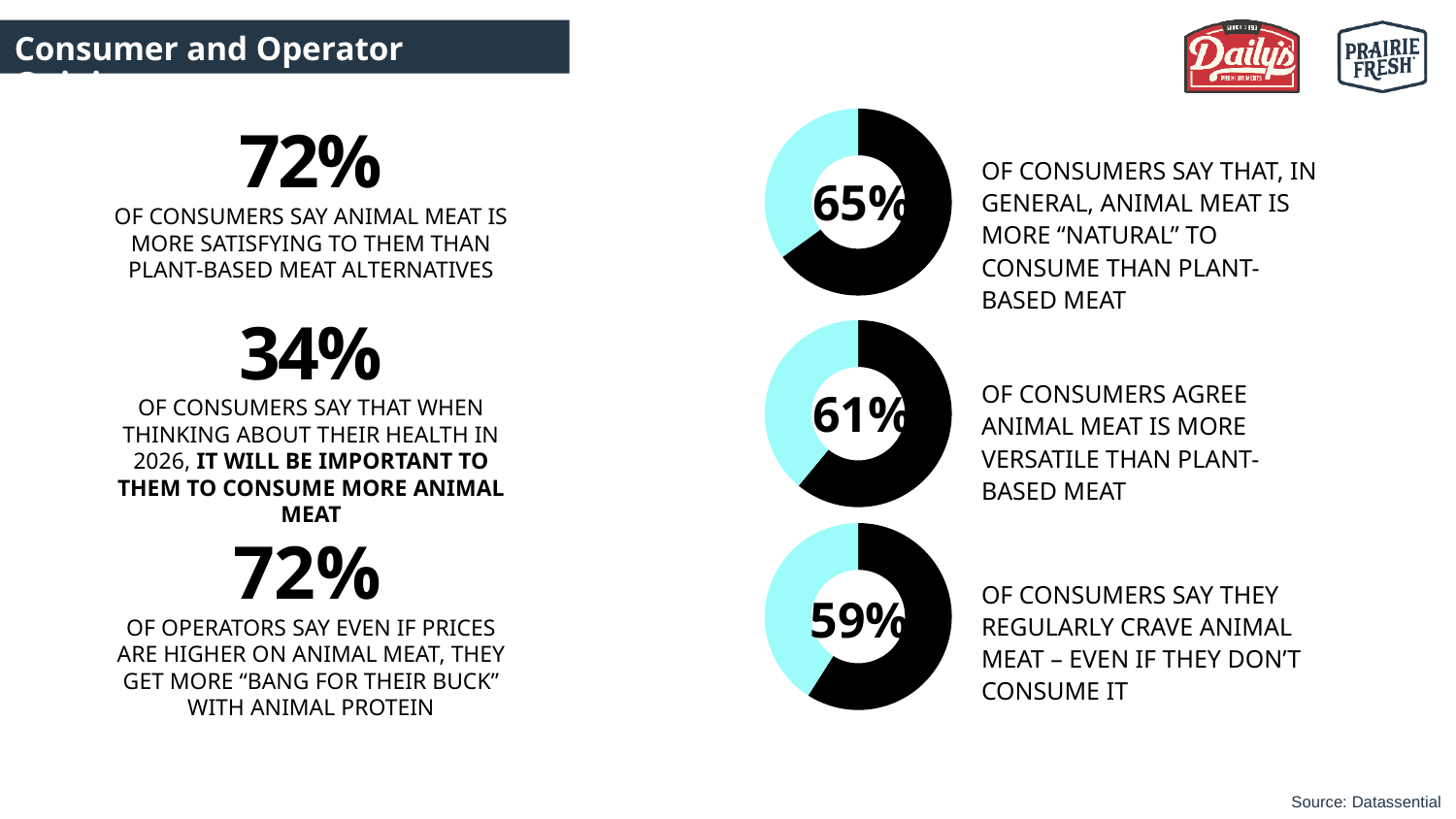
Which is larger: the value in the top donut chart or the value in the middle donut chart? The top donut chart (65%) Which of the three donut charts shows the highest percentage? The top one (65%) What value is shown in the centre of the top donut chart (animal meat is more "natural" to consume)? 65% What kind of chart is used on the right side of the slide? Donut (pie) chart What value is shown in the bottom donut chart (consumers regularly crave animal meat)? 59% What share of the bottom donut chart does the light blue slice represent? 41% What colour is the larger slice in each donut chart? Black How many slices does each donut chart have? 2 What value is shown in the middle donut chart (animal meat is more versatile than plant-based meat)? 61% Which of the three donut charts shows the lowest percentage? The bottom one (59%) What is the difference between the value in the top donut chart and the value in the bottom donut chart? 6 percentage points How many donut charts are on the slide? 3